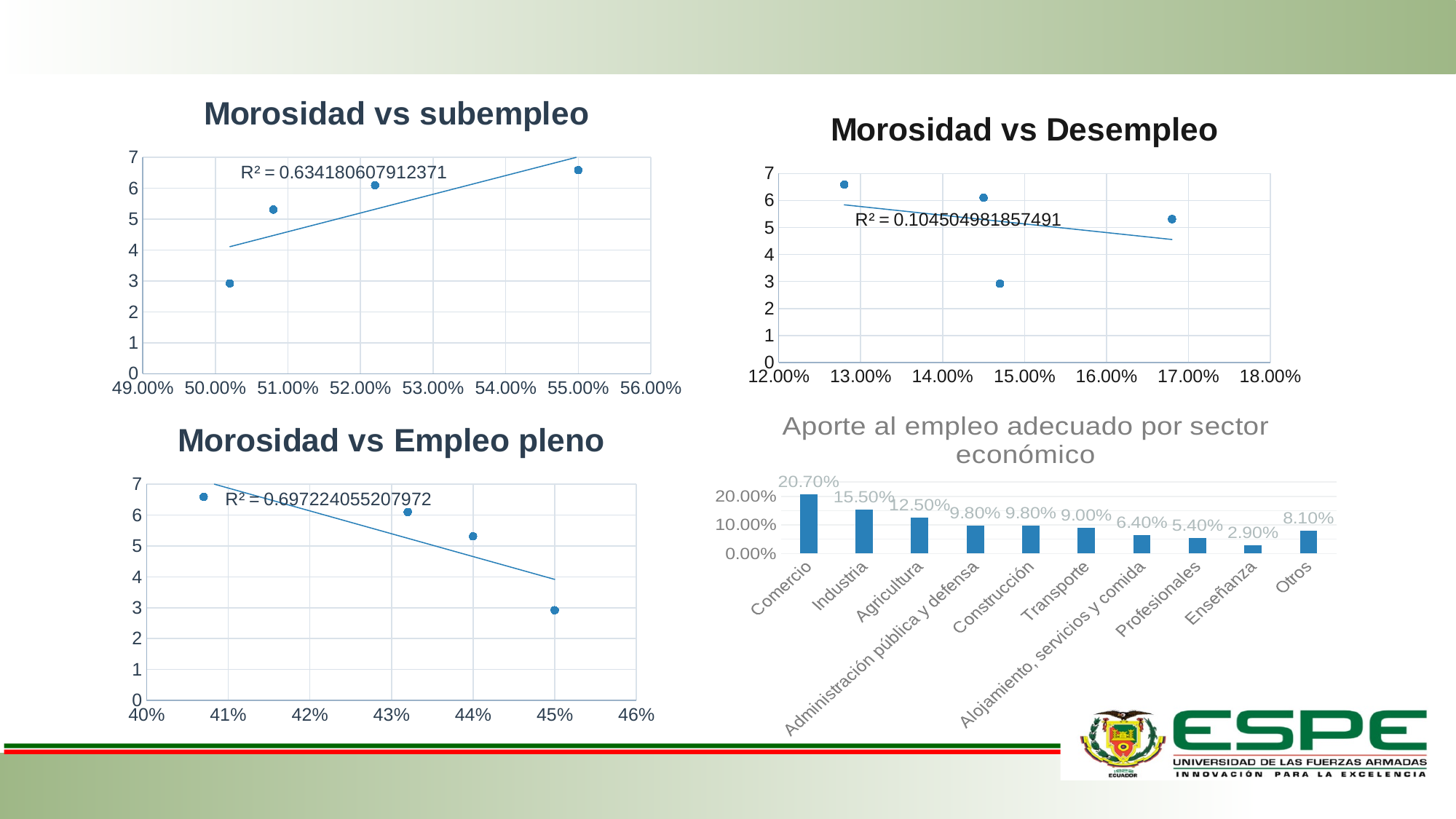
In the 'Aporte al empleo adecuado por sector económico' chart, which is larger, Otros or Profesionales? Otros In the 'Aporte al empleo adecuado por sector económico' chart, what is the difference between Comercio and Industria? 5.20% In the 'Aporte al empleo adecuado por sector económico' chart, what is the value for Comercio? 20.70% What R² value is shown on the 'Morosidad vs Empleo pleno' chart? 0.697224055207972 What R² value is shown on the 'Morosidad vs subempleo' chart? 0.634180607912371 In the 'Aporte al empleo adecuado por sector económico' chart, which sector has the highest value? Comercio What kind of chart is 'Aporte al empleo adecuado por sector económico'? Bar chart How many sectors are shown in the 'Aporte al empleo adecuado por sector económico' chart? 10 In the 'Aporte al empleo adecuado por sector económico' chart, what is the value for Enseñanza? 2.90% In the 'Morosidad vs Empleo pleno' chart, does the trendline rise or fall as the x-axis value increases? Fall In the 'Aporte al empleo adecuado por sector económico' chart, which sector has the lowest value? Enseñanza How many data points are plotted in the 'Morosidad vs Desempleo' chart? 4